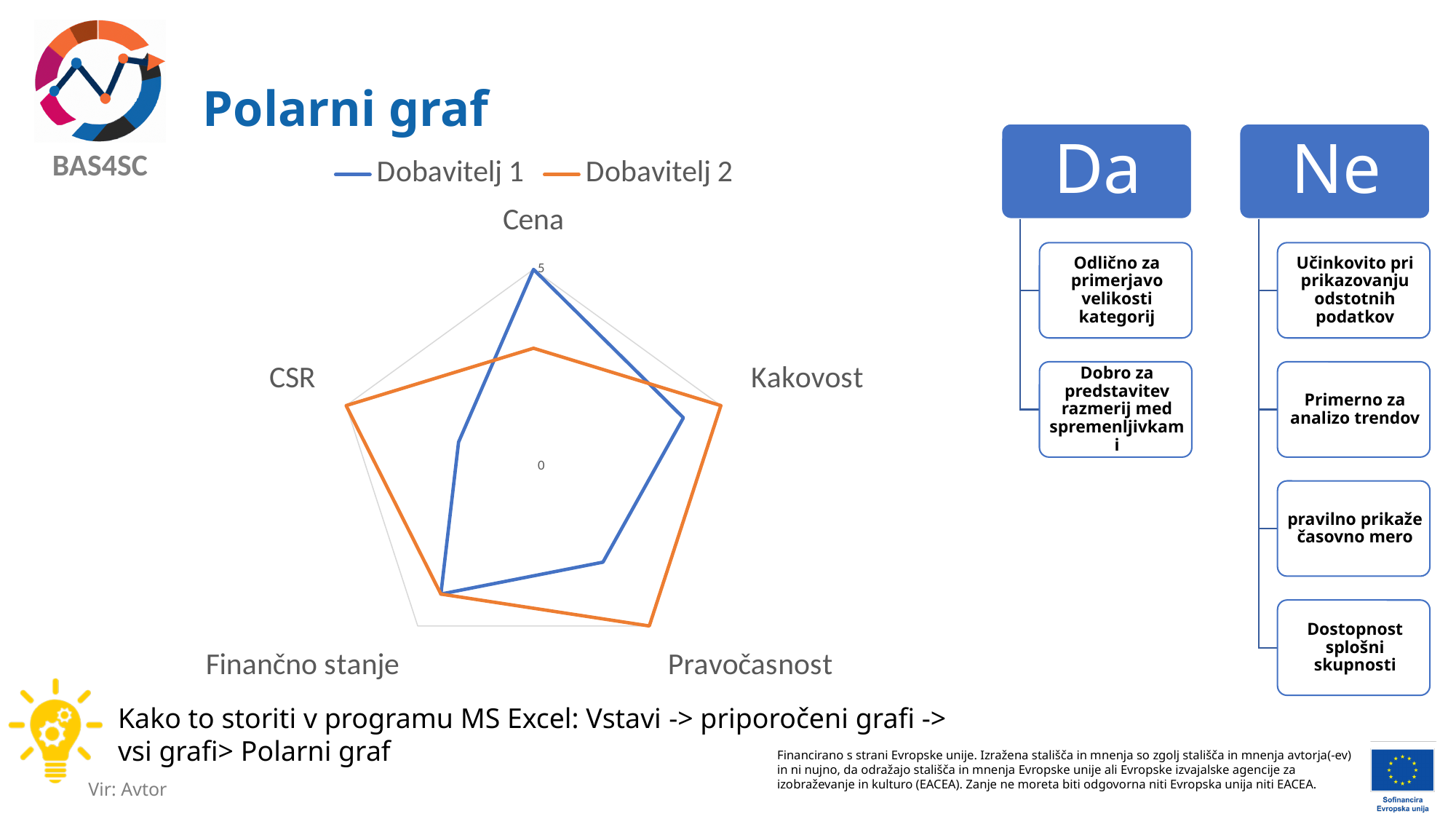
What is the value for Dobavitelj 1 on the Cena axis? 5 Which series has the larger value for Kakovost, Dobavitelj 1 or Dobavitelj 2? Dobavitelj 2 How many categories (axes) does the radar chart have? 5 Which series has the larger value for Cena, Dobavitelj 1 or Dobavitelj 2? Dobavitelj 1 Which series has the larger value for CSR, Dobavitelj 1 or Dobavitelj 2? Dobavitelj 2 Which colour represents Dobavitelj 2 in the chart? Orange On which axis does Dobavitelj 2 have its lowest value? Cena How many series does the chart legend list? 2 On which axis does Dobavitelj 1 reach its highest value? Cena What kind of chart is shown on the slide? Radar chart On which axis does Dobavitelj 1 have its lowest value? CSR